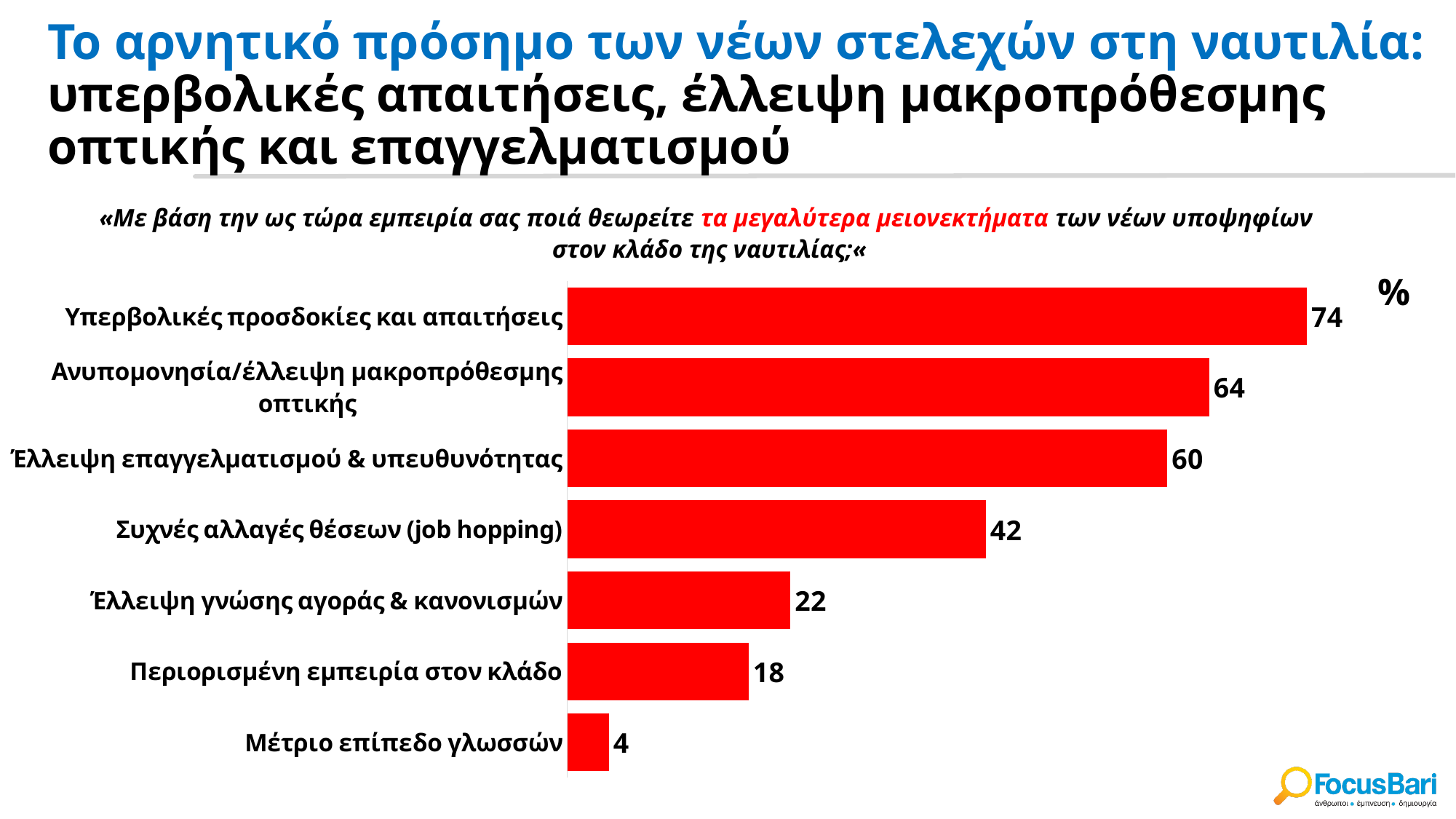
What is the difference between the values for «Υπερβολικές προσδοκίες και απαιτήσεις» and «Μέτριο επίπεδο γλωσσών»? 70 Which is larger: the value for «Συχνές αλλαγές θέσεων (job hopping)» or the value for «Έλλειψη γνώσης αγοράς & κανονισμών»? Συχνές αλλαγές θέσεων (job hopping) How many categories are shown in the chart? 7 What value is shown for «Έλλειψη γνώσης αγοράς & κανονισμών»? 22 What value is shown for «Υπερβολικές προσδοκίες και απαιτήσεις»? 74 What colour are the bars in the chart? Red What kind of chart is shown on the slide? Bar chart What value is shown for «Συχνές αλλαγές θέσεων (job hopping)»? 42 Which category has the lowest value? Μέτριο επίπεδο γλωσσών What value is shown for «Περιορισμένη εμπειρία στον κλάδο»? 18 What is the difference between the values for «Ανυπομονησία/έλλειψη μακροπρόθεσμης οπτικής» and «Έλλειψη επαγγελματισμού & υπευθυνότητας»? 4 Which category has the highest value? Υπερβολικές προσδοκίες και απαιτήσεις